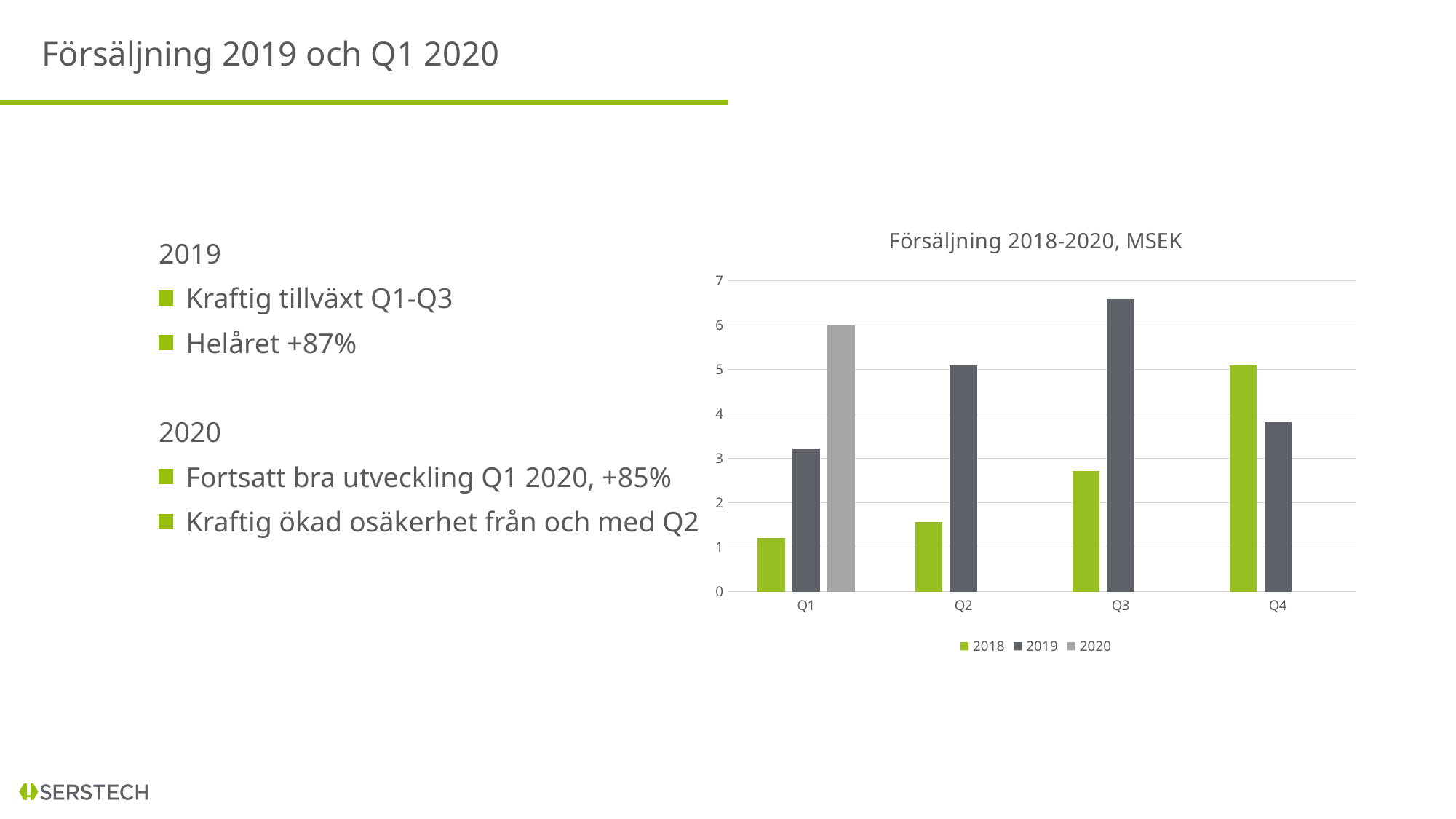
In which quarter is the 2018 series lowest? Q1 Do the 2018 values rise or fall from Q1 to Q4? rise What is the title of the chart? Försäljning 2018-2020, MSEK What kind of chart is shown on the slide? bar chart Is the 2019 value for Q3 greater or less than 6? greater How many quarters are shown on the x axis? 4 In which quarter is the 2018 series highest? Q4 How many series does the legend list? 3 Which series is shown in green in the legend? 2018 Which is larger in Q4, the 2018 value or the 2019 value? 2018 Which is larger in Q1, the 2019 value or the 2020 value? 2020 In which quarter is the 2019 series highest? Q3